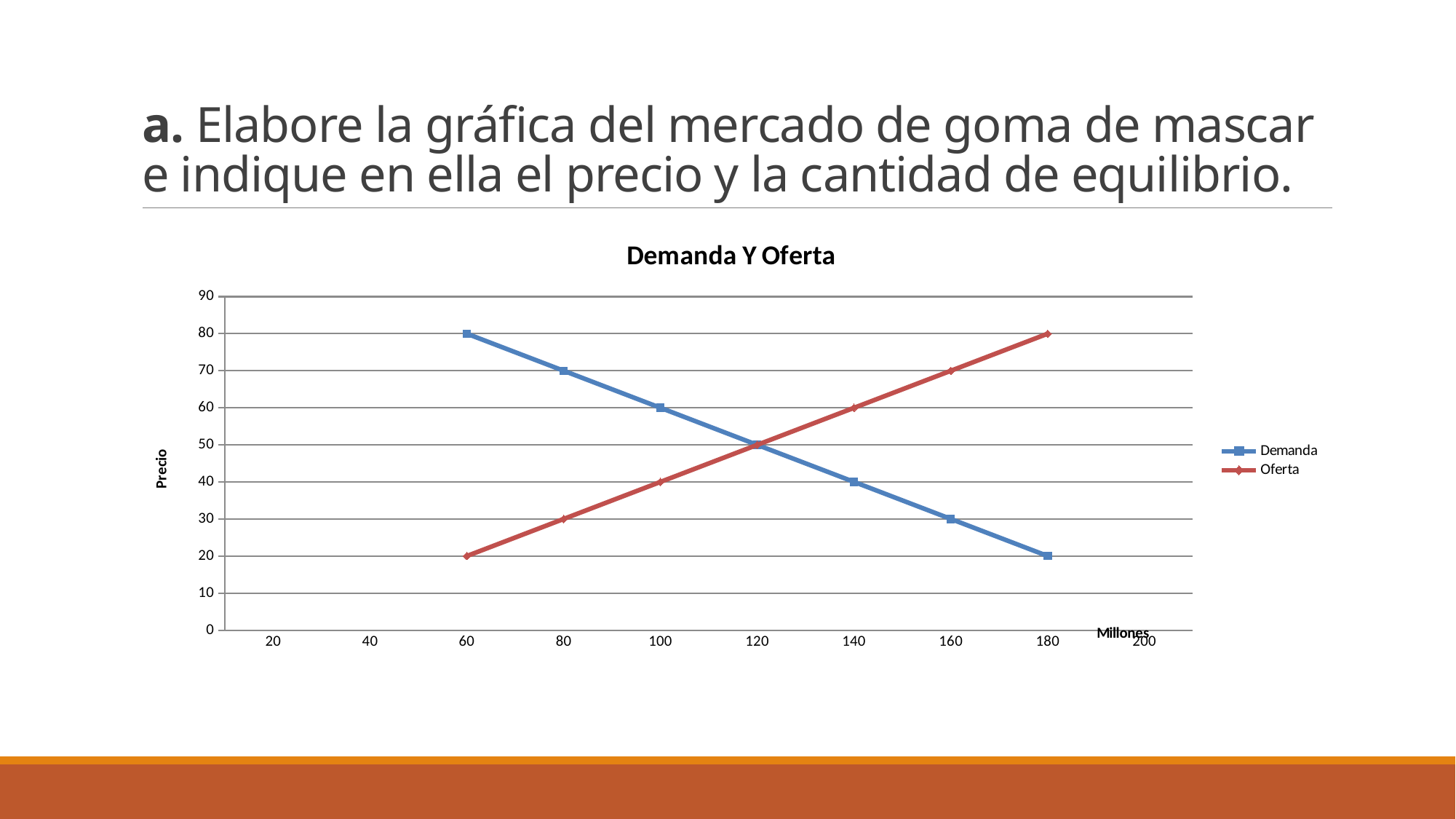
At what quantity do the Demanda and Oferta lines intersect? 120 What is the title of the chart? Demanda Y Oferta What is the Oferta value at a quantity of 180? 80 How many series does the legend list? 2 What is the Demanda value at a quantity of 60? 80 What is the price at which the Demanda and Oferta lines intersect? 50 What is the label of the vertical axis? Precio What kind of chart is shown on the slide? Line chart What is the difference between the Oferta value and the Demanda value at a quantity of 80? 40 Does the Oferta line rise or fall as quantity increases along the x axis? Rises Does the Demanda line rise or fall as quantity increases along the x axis? Falls At a quantity of 160, which series has the larger value, Demanda or Oferta? Oferta